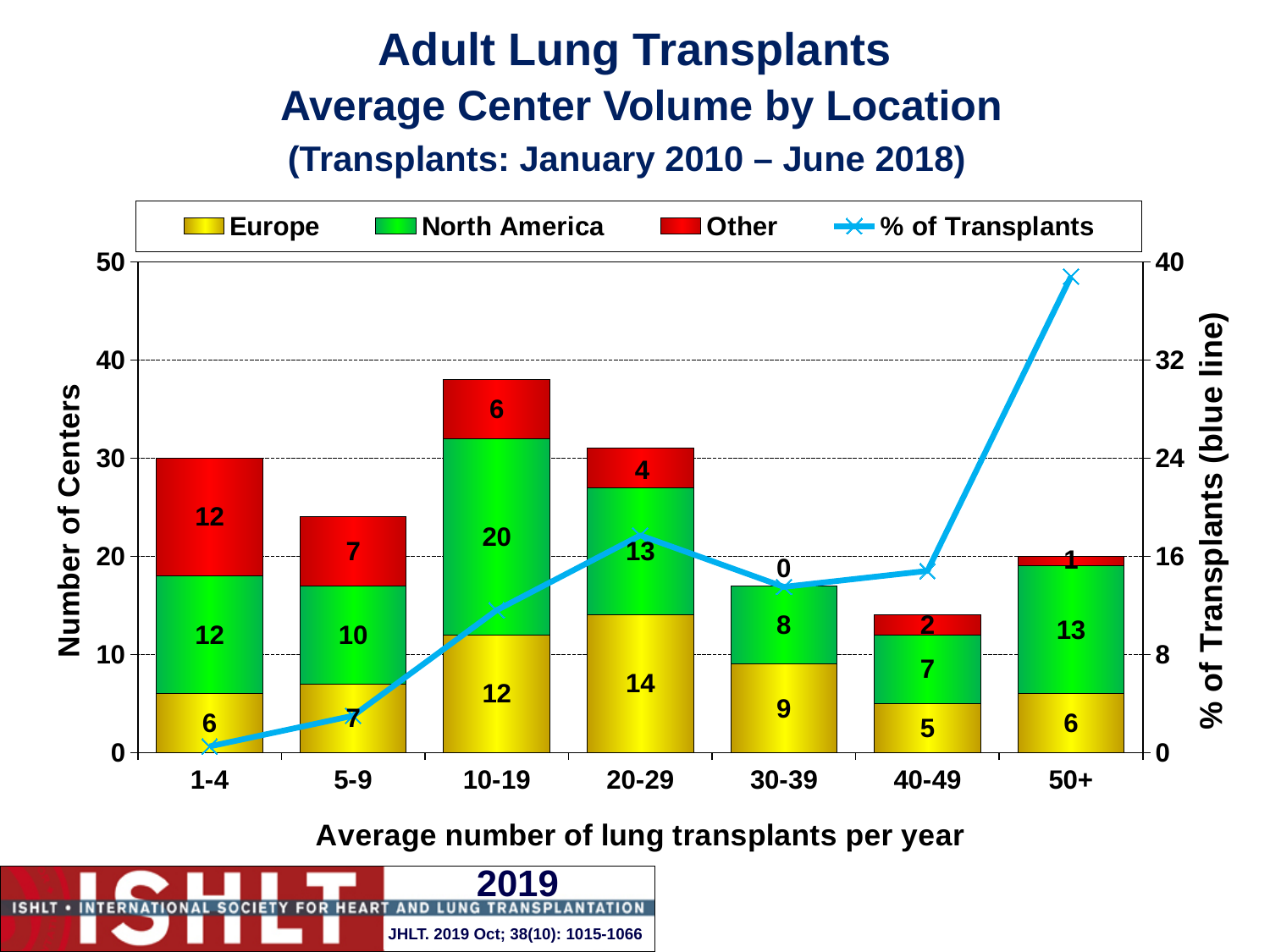
What kind of chart is shown on the slide? stacked bar chart with a line What is the difference between the North America values for 10-19 and 5-9? 10 Which category has the highest number of North America centers? 10-19 What is the value for Other in the 1-4 category? 12 How many centers in Europe have an average of 20-29 lung transplants per year? 14 Is the % of Transplants value for the 50+ category greater or less than 32? greater How many series does the legend list? 4 How many categories are shown on the x axis? 7 What is the number of North America centers in the 10-19 category? 20 Which has more Europe centers, the 20-29 category or the 10-19 category? 20-29 What is the total number of centers in the 10-19 stacked bar? 38 Which category has the lowest value for Other? 30-39